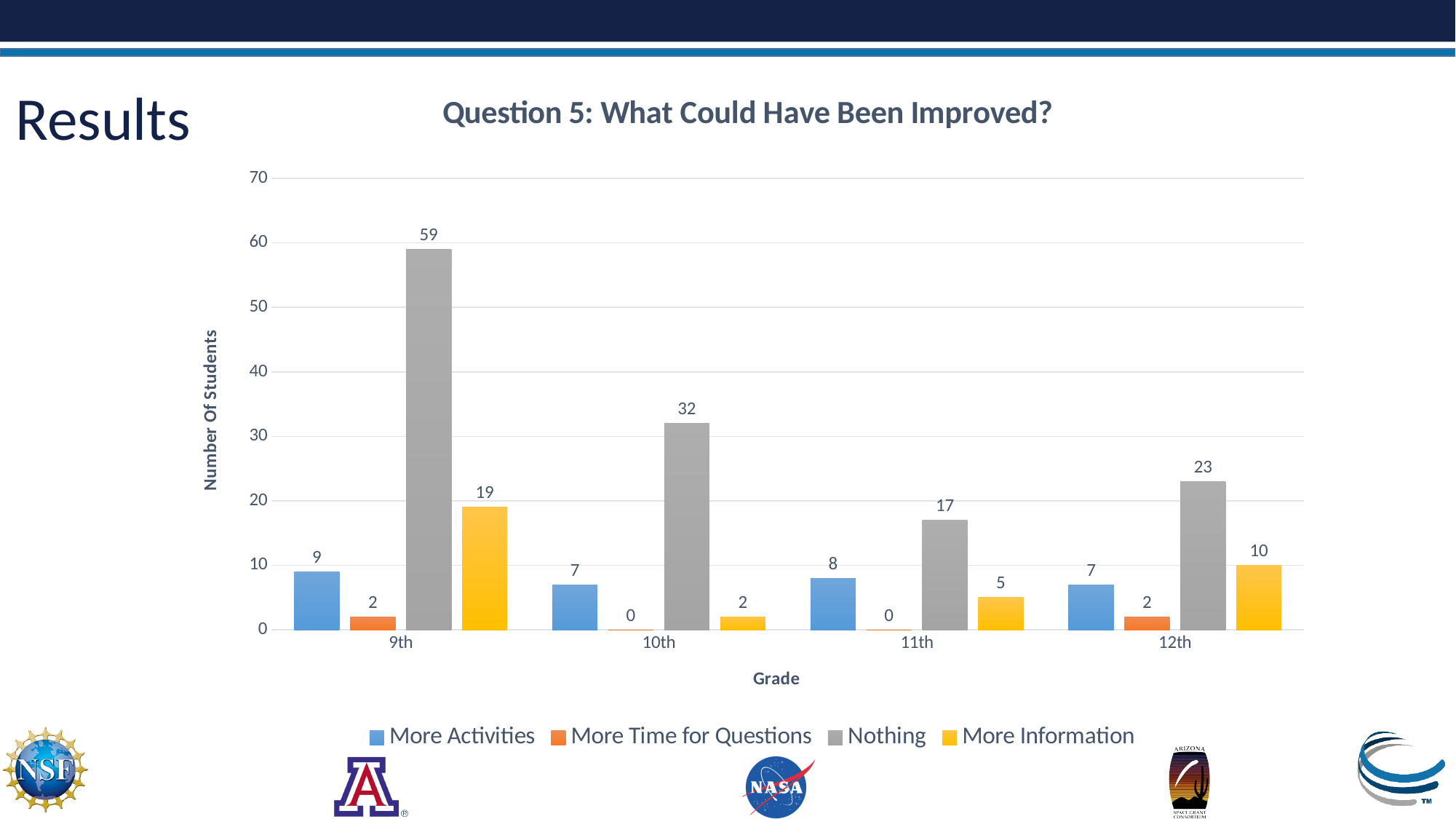
What is the title of the chart? Question 5: What Could Have Been Improved? What kind of chart is shown? bar chart Which grade has the highest value for Nothing? 9th What is the value for More Time for Questions in 11th grade? 0 Do the Nothing values rise or fall from 9th to 11th grade? fall Which is larger: More Activities in 9th grade or More Activities in 11th grade? 9th grade How many series does the legend list? 4 What is the value for Nothing in 9th grade? 59 What is the value for More Information in 12th grade? 10 How many grade categories are shown on the x axis? 4 What is the difference between the Nothing values for 9th and 10th grade? 27 Which grade has the lowest value for More Information? 10th